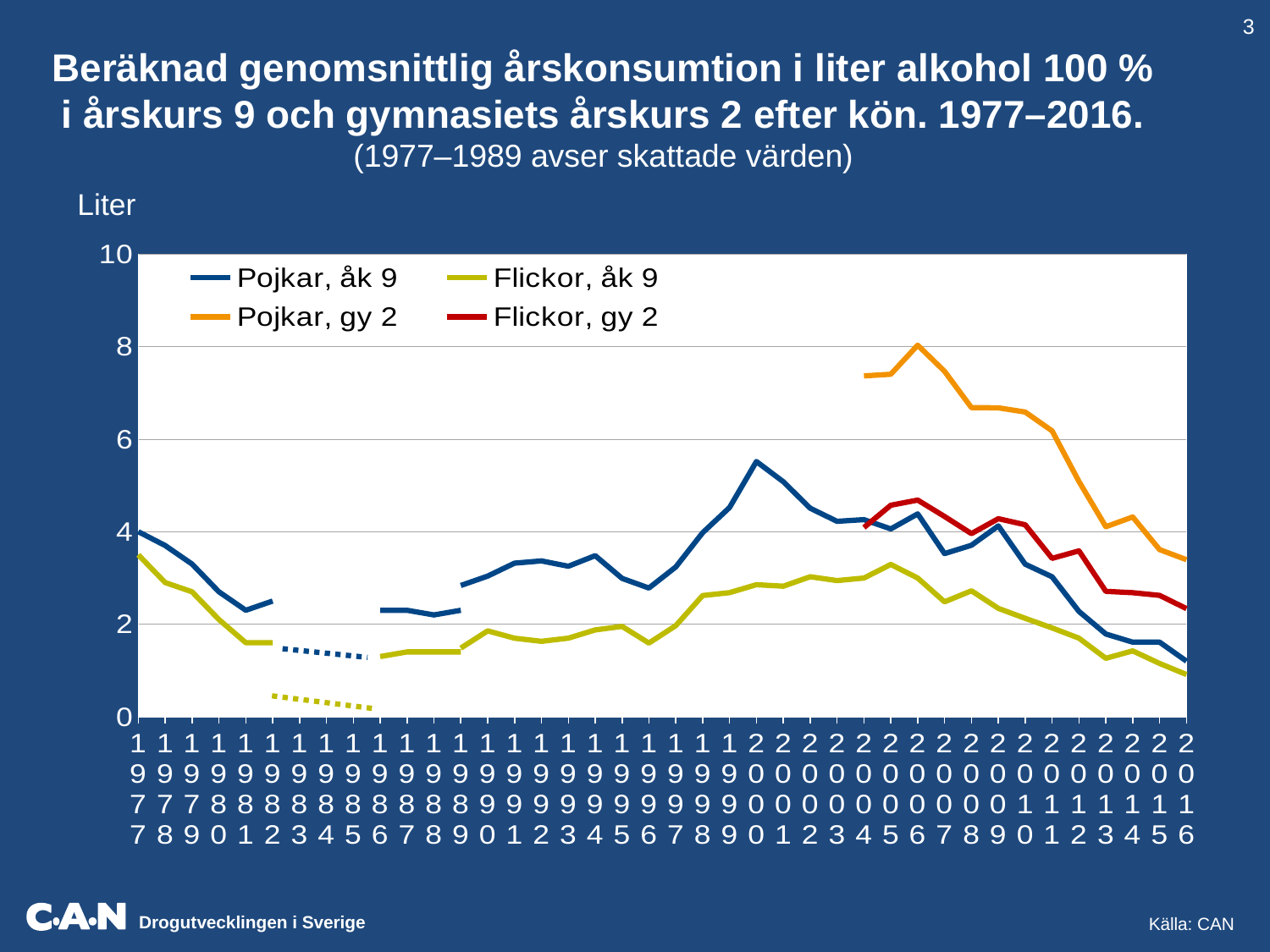
In 2006, which is larger: the value for Pojkar, gy 2 or the value for Flickor, gy 2? Pojkar, gy 2 Does the value for Pojkar, gy 2 rise or fall from 2006 to 2016? fall Is the value for Pojkar, gy 2 in 2006 greater or less than 6? greater What kind of chart is shown on the slide? Line chart Which series has the lowest value in 2016? Flickor, åk 9 Is the value for Pojkar, åk 9 in 2000 greater or less than 4? greater How many series does the legend list? 4 Is the value for Flickor, åk 9 in 2016 greater or less than 2? less What is the label on the vertical axis of the chart? Liter Which series reaches the highest value anywhere on the chart? Pojkar, gy 2 Which series is drawn in orange? Pojkar, gy 2